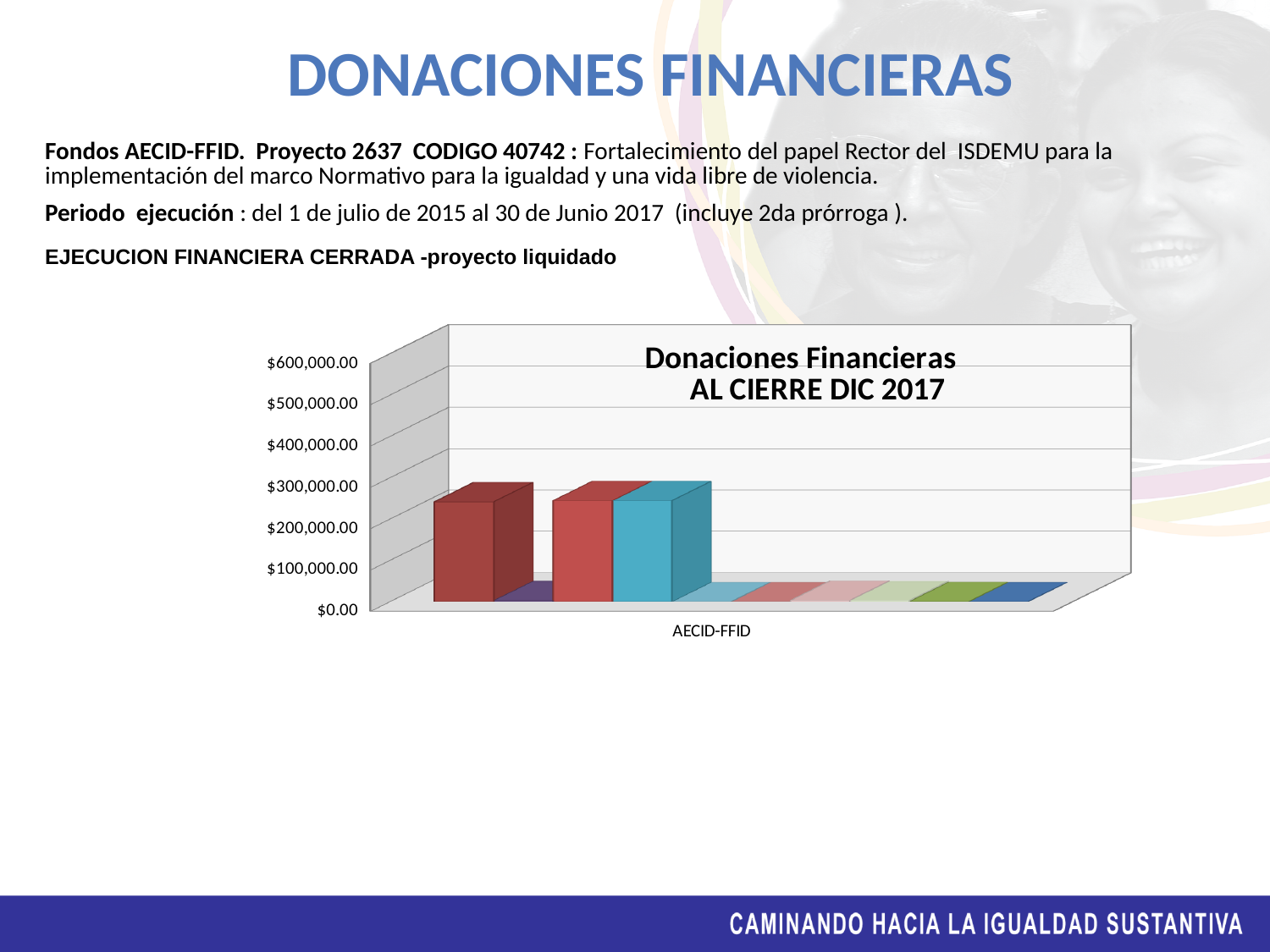
What is the category label shown on the x axis of the chart? AECID-FFID Is the value of the dark red bar (leftmost) greater or less than $200,000.00? greater What is the lowest value shown on the y axis of the chart? $0.00 Is the value of the purple bar greater or less than $100,000.00? less What kind of chart is shown on the slide? bar chart Is the value of the teal bar greater or less than $200,000.00? greater How many bars in the chart rise clearly above $100,000.00? 3 What is the title of the chart? Donaciones Financieras AL CIERRE DIC 2017 How many categories are shown on the x axis of the chart? 1 What is the highest value shown on the y axis of the chart? $600,000.00